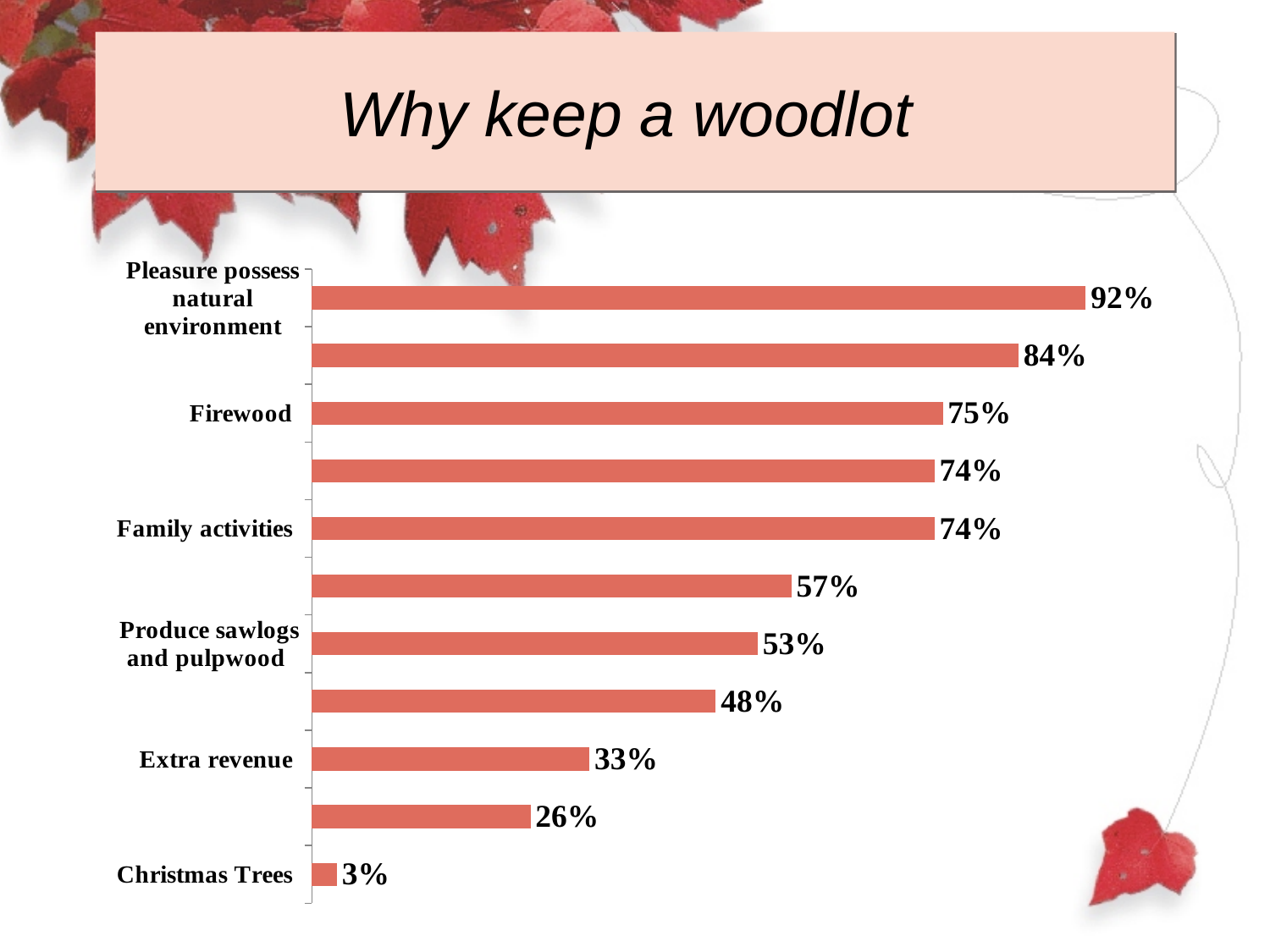
What is the value for Firewood? 75% What kind of chart is shown on the slide? Bar chart How many bars are plotted in the chart? 11 What is the value for Family activities? 74% What is the value for Pleasure possess natural environment? 92% What is the difference between the values for Firewood and Extra revenue? 42% Which is larger, the value for Family activities or the value for Produce sawlogs and pulpwood? Family activities What is the value for Extra revenue? 33% What is the value for Christmas Trees? 3% Which category has the highest value? Pleasure possess natural environment What is the value for Produce sawlogs and pulpwood? 53% Which category has the lowest value? Christmas Trees